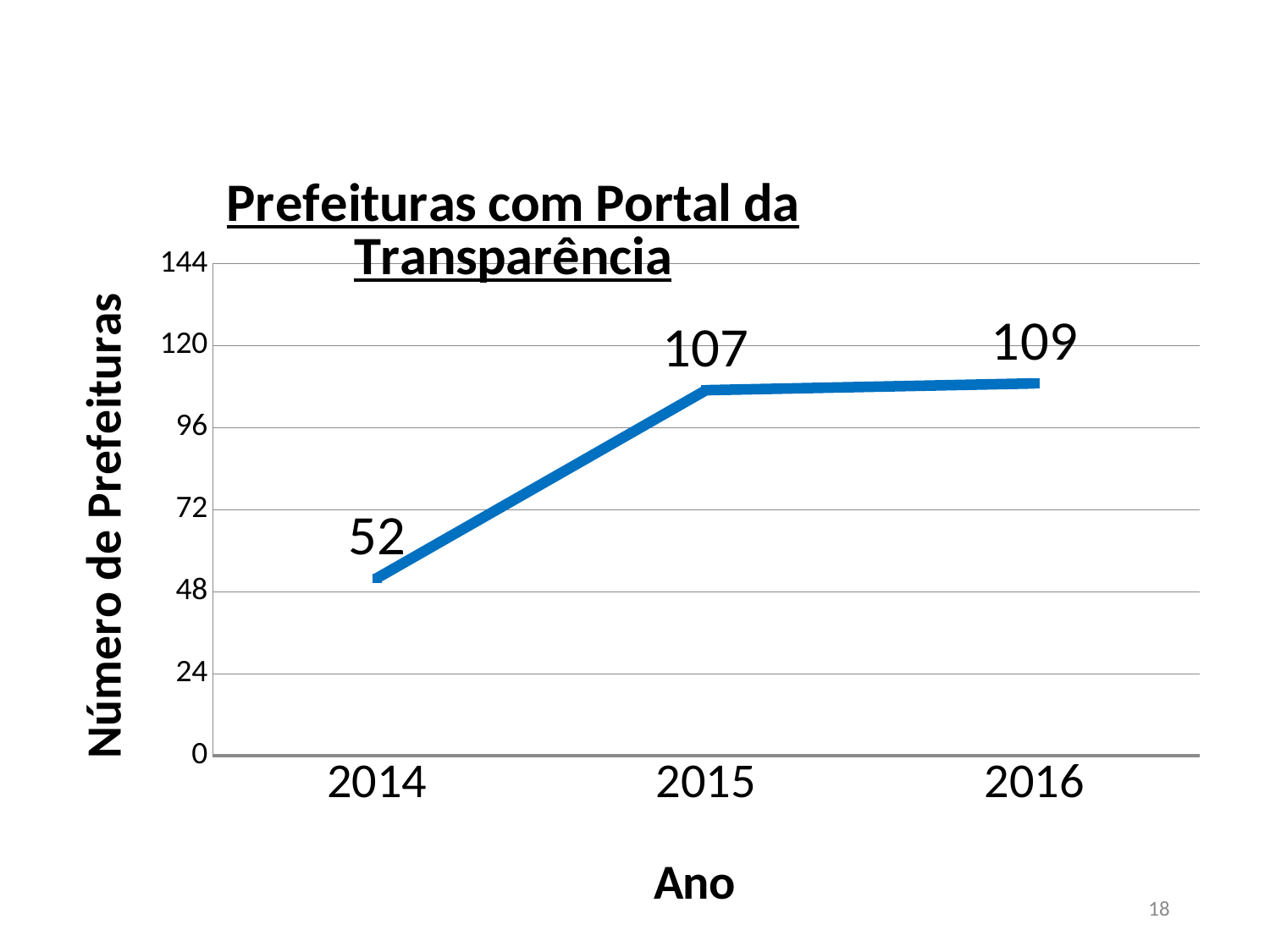
How many years are plotted on the chart? 3 Is the value for 2014 greater or less than 72? less What kind of chart is shown? line chart Which year has the highest number of Prefeituras? 2016 What is the value for 2016? 109 Which is larger, the value for 2014 or the value for 2015? 2015 What is the difference between the values for 2016 and 2015? 2 Do the values rise or fall from 2014 to 2016? rise What is the difference between the values for 2015 and 2014? 55 Which year has the lowest number of Prefeituras? 2014 What is the value for 2015? 107 What is the value for 2014? 52